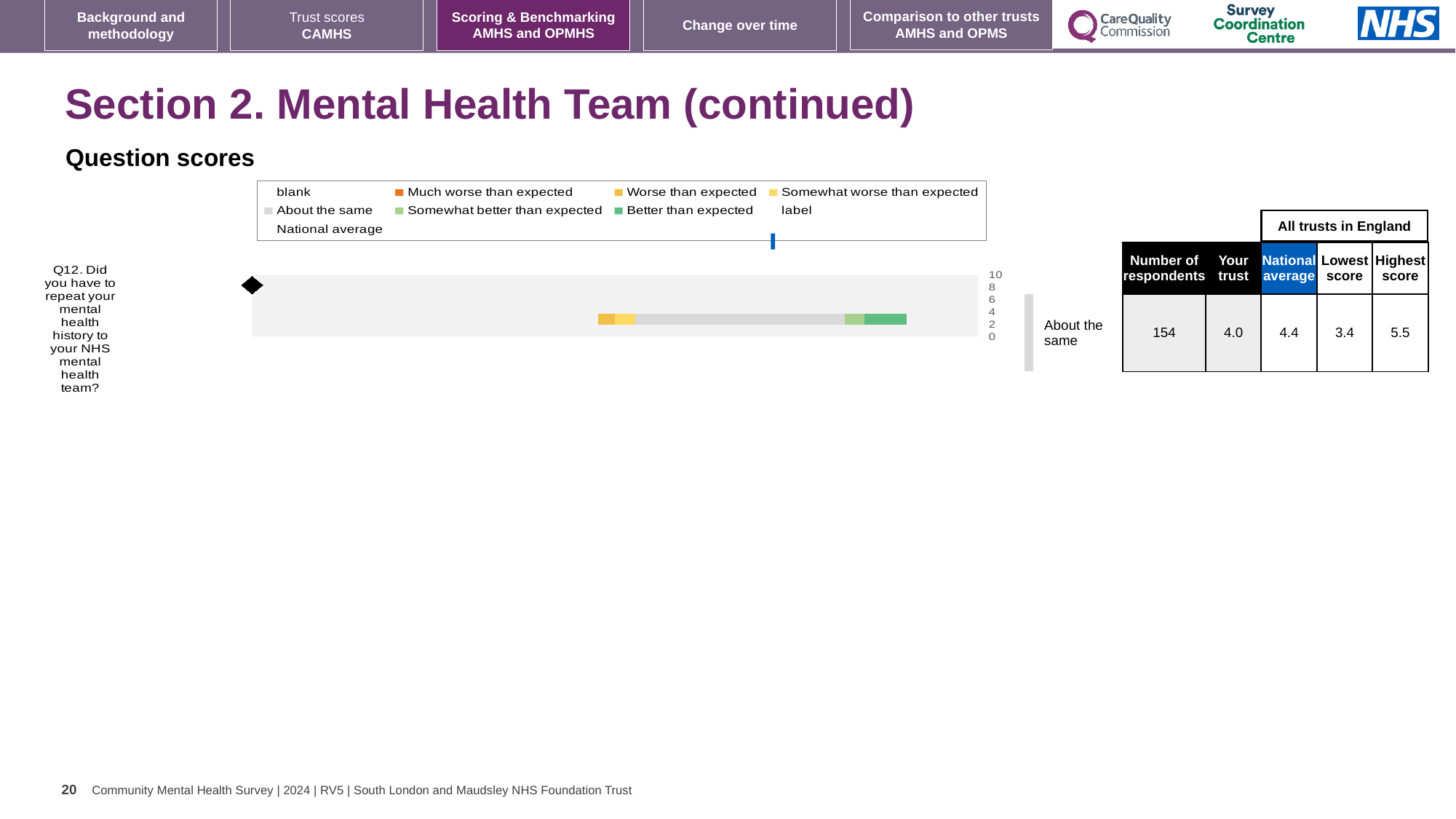
For Q12, which is larger: the 'Your trust' score or the national average? National average In the table beside the chart, what is the lowest score among all trusts in England for Q12? 3.4 What benchmark category label is shown to the right of the Q12 bar? About the same In the table beside the chart, what is the national average score for Q12? 4.4 Which legend entry is shown with an orange marker? Much worse than expected In the table beside the chart, what is the 'Your trust' score for Q12? 4.0 In the table beside the chart, what is the highest score among all trusts in England for Q12? 5.5 What kind of chart is used to show the Q12 question score? bar chart For Q12, what is the difference between the highest score and the lowest score among all trusts in England? 2.1 How many respondents answered Q12 according to the table beside the chart? 154 How many questions are plotted in the question scores chart? 1 For Q12, what is the difference between the national average and the 'Your trust' score? 0.4